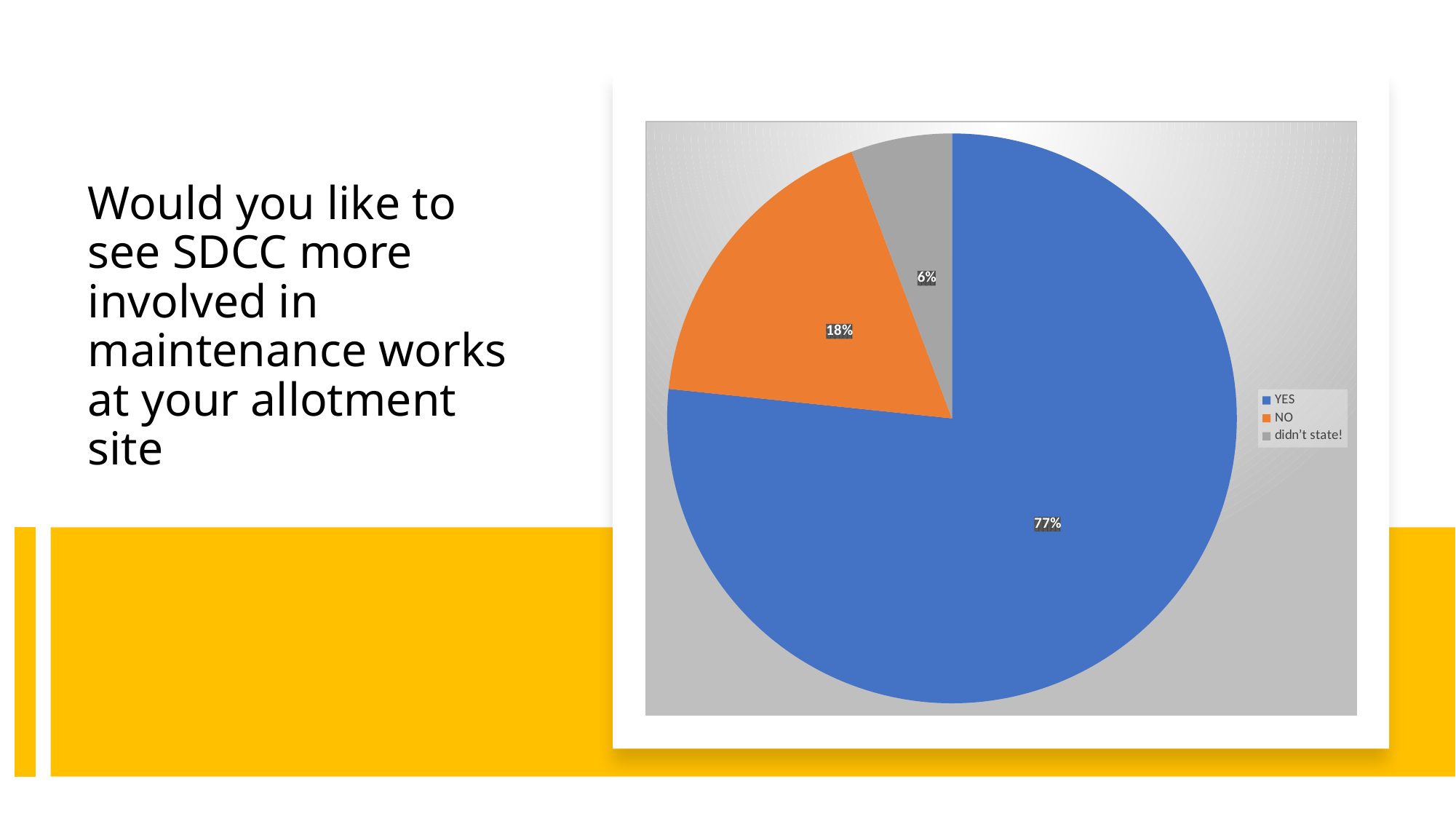
What percentage of respondents answered NO? 18% Which category has the smallest share of the pie? didn't state! What percentage of respondents answered YES? 77% What is the difference in percentage points between the YES and NO slices? 59 Which is larger, the NO slice or the didn't state! slice? NO What colour is the YES slice? blue What percentage of respondents didn't state an answer? 6% Which category has the largest share of the pie? YES How many slices does the pie chart have? 3 What kind of chart is shown on the slide? pie chart What is the difference in percentage points between the NO slice and the didn't state! slice? 12 How many entries does the legend list? 3